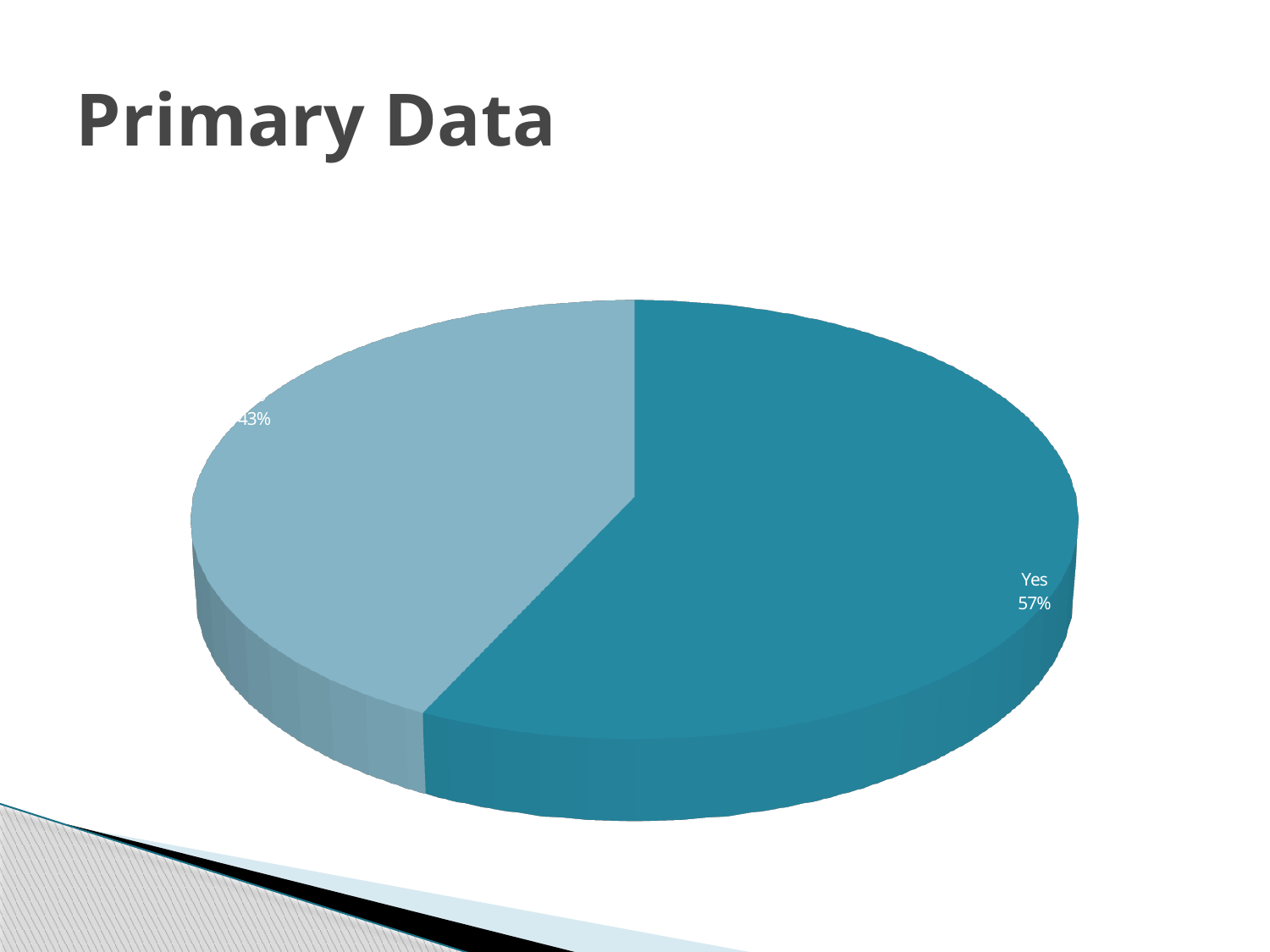
What share of the pie does the "Yes" slice represent? 57% What colour is the "Yes" slice compared with the other slice? darker blue Is the value for "Yes" greater or less than 50%? greater How many slices does the pie chart have? 2 Is the "Yes" slice larger or smaller than the other slice? larger What kind of chart is shown on the slide? pie chart What percentage does the "Yes" slice show? 57% What is the title of the slide containing the pie chart? Primary Data What percentage is shown on the lighter blue slice of the pie chart? 43% Which slice of the pie chart is the largest? Yes What is the difference in percentage points between the "Yes" slice and the 43% slice? 14